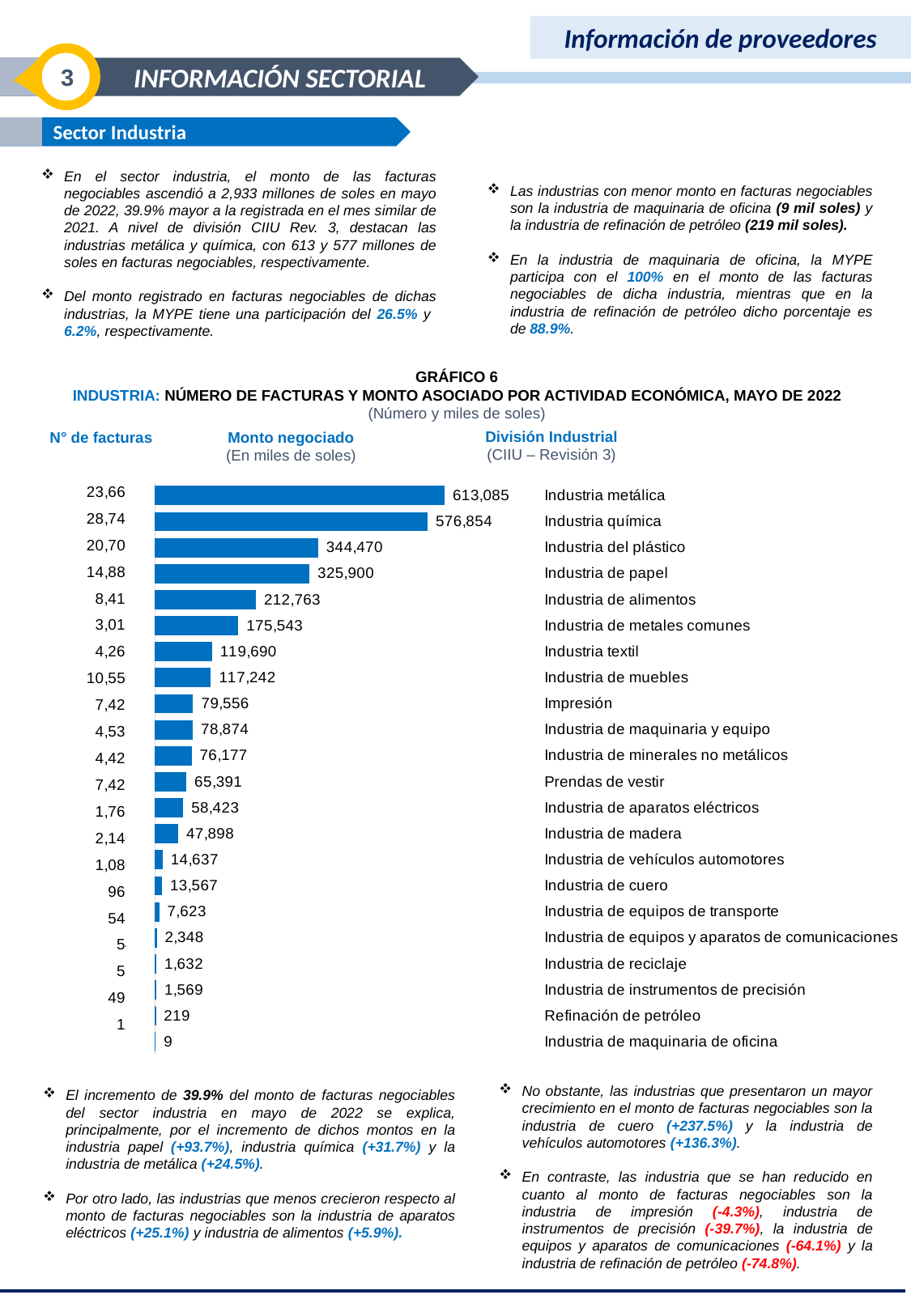
In Gráfico 6, what is the monto negociado (en miles de soles) for Industria metálica? 613,085 In Gráfico 6, what is the difference in monto negociado (en miles de soles) between Industria metálica and Industria química? 36,231 In Gráfico 6, what is the difference in monto negociado (en miles de soles) between Industria del plástico and Industria de papel? 18,570 In Gráfico 6, which industrial division has the highest monto negociado? Industria metálica What type of chart is Gráfico 6? Bar chart How many industrial divisions are shown in Gráfico 6? 22 In Gráfico 6, which industrial division has the lowest monto negociado? Industria de maquinaria de oficina In Gráfico 6, what is the monto negociado (en miles de soles) for Industria de cuero? 13,567 In Gráfico 6, do the monto negociado values increase or decrease going from the top bar to the bottom bar? Decrease In Gráfico 6, what is the monto negociado (en miles de soles) for Industria de papel? 325,900 In Gráfico 6, which has a larger monto negociado: Industria textil or Industria de muebles? Industria textil In Gráfico 6, what is the monto negociado (en miles de soles) for Refinación de petróleo? 219